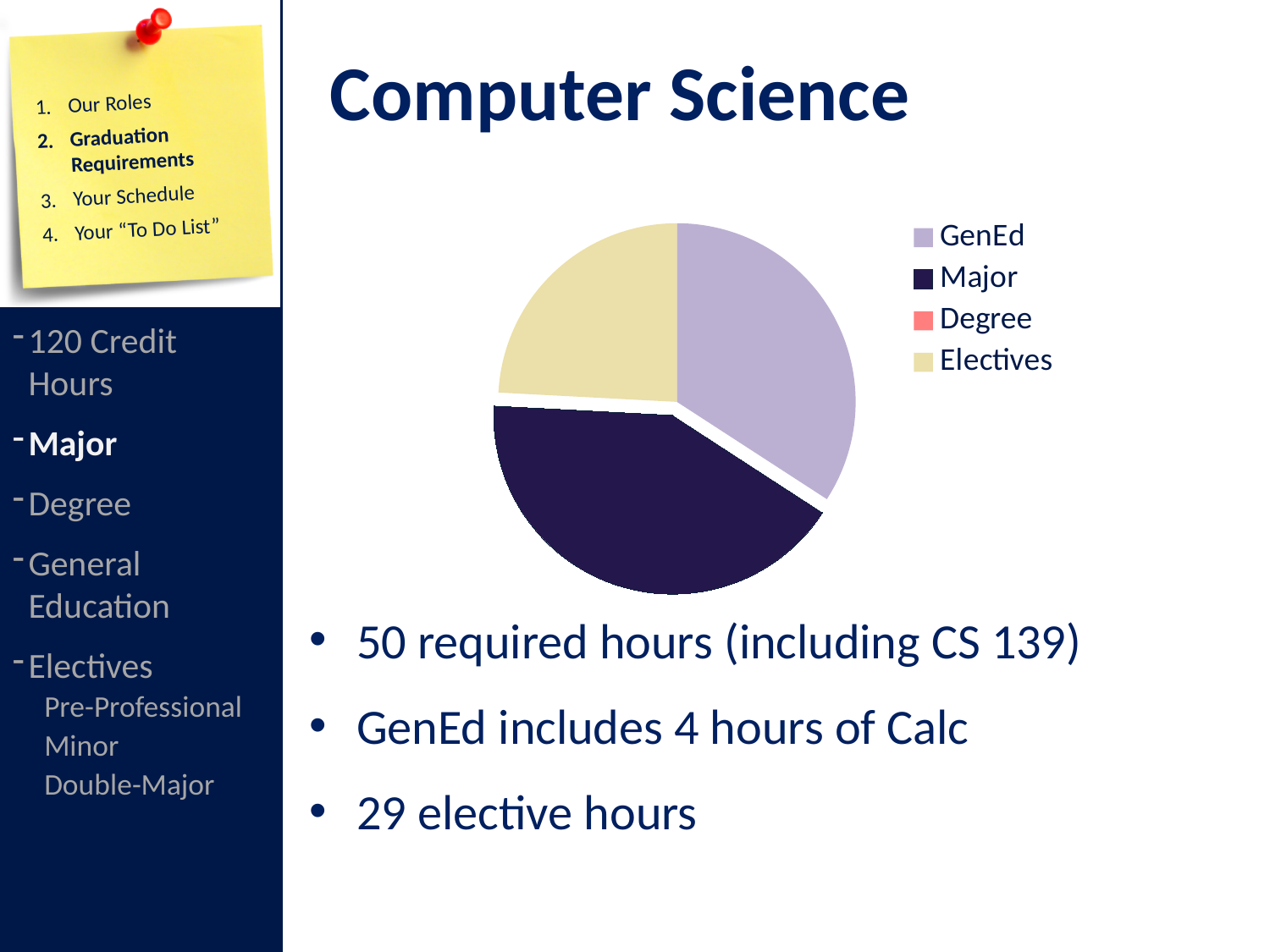
Which slice is larger, Major or GenEd? Major How many entries does the chart's legend list? 4 Which slice is larger, Major or Electives? Major Which legend entry is shown in the darkest colour? Major What are the four categories listed in the chart's legend? GenEd, Major, Degree, Electives Which category has the largest slice of the pie? Major Which slice is larger, GenEd or Electives? GenEd What kind of chart is shown on the slide? pie chart